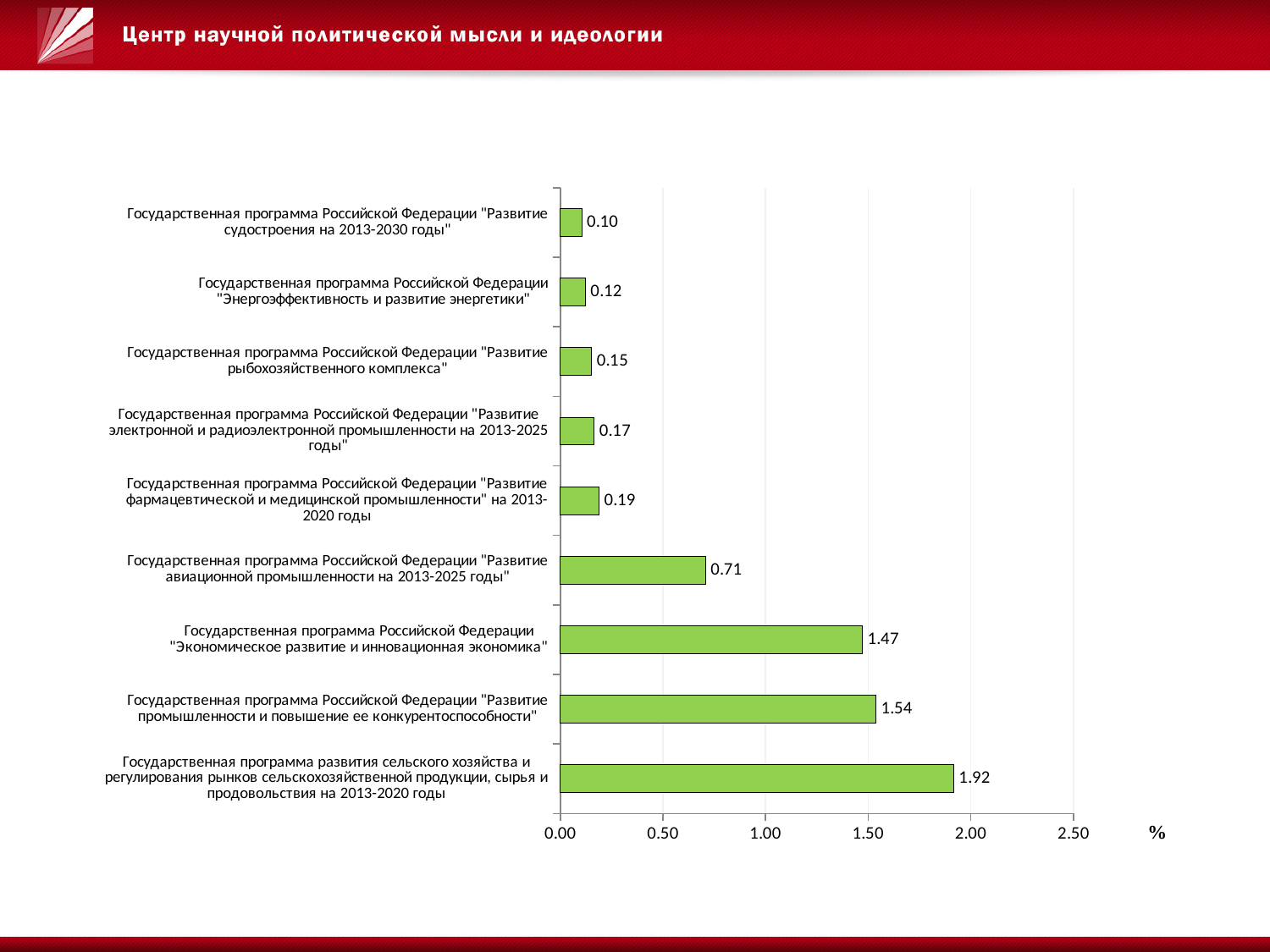
How many government programmes (bars) are plotted on the chart? 9 What unit is indicated at the end of the horizontal axis? % Which has the larger value: "Развитие рыбохозяйственного комплекса" or "Энергоэффективность и развитие энергетики"? Развитие рыбохозяйственного комплекса What is the value for the programme "Развитие авиационной промышленности на 2013-2025 годы"? 0.71 What is the value for the programme "Развитие фармацевтической и медицинской промышленности" на 2013-2020 годы? 0.19 Which programme has the highest value on the chart? Государственная программа развития сельского хозяйства и регулирования рынков сельскохозяйственной продукции, сырья и продовольствия на 2013-2020 годы What is the difference between the value for "Развитие промышленности и повышение ее конкурентоспособности" (1.54) and "Экономическое развитие и инновационная экономика" (1.47)? 0.07 What is the value for the programme "Развитие судостроения на 2013-2030 годы"? 0.10 What is the value for the programme "Экономическое развитие и инновационная экономика"? 1.47 What kind of chart is shown on the slide? bar chart Which programme has the lowest value on the chart? Государственная программа Российской Федерации "Развитие судостроения на 2013-2030 годы" Is the value for the agricultural development programme (сельского хозяйства) greater or less than 1.50? greater